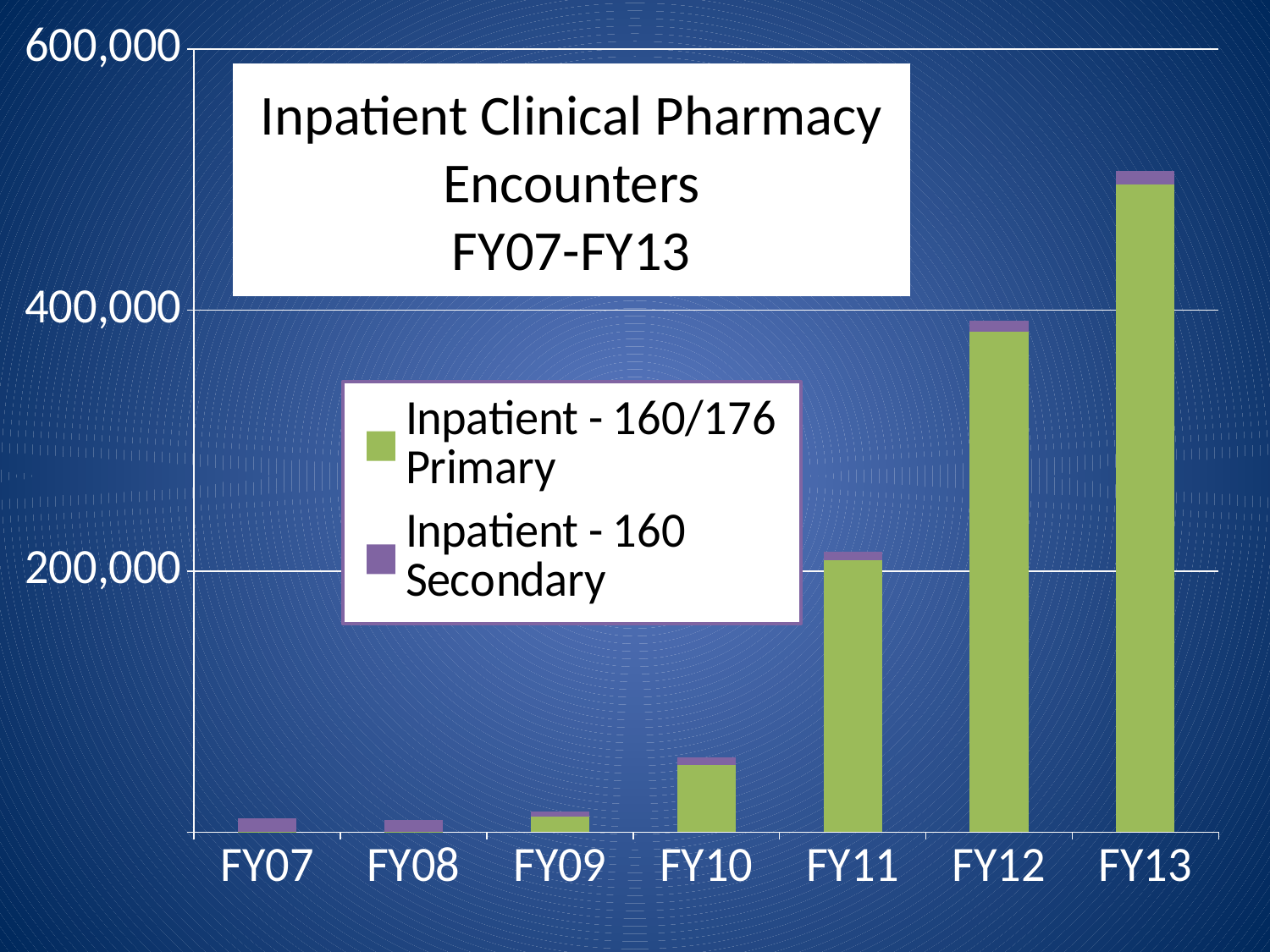
What is the title of the chart? Inpatient Clinical Pharmacy Encounters FY07-FY13 Which series is shown in green? Inpatient - 160/176 Primary Is the total for FY13 greater or less than 400,000? greater How many series does the legend list? 2 What kind of chart is shown on the slide? stacked bar chart Which fiscal year has the highest total encounters? FY13 Is the total for FY12 greater or less than 400,000? less How many fiscal years are shown on the x axis? 7 Do the total encounters generally rise or fall from FY09 to FY13? rise Which is larger, the total for FY11 or the total for FY12? FY12 Is the total for FY10 greater or less than 200,000? less